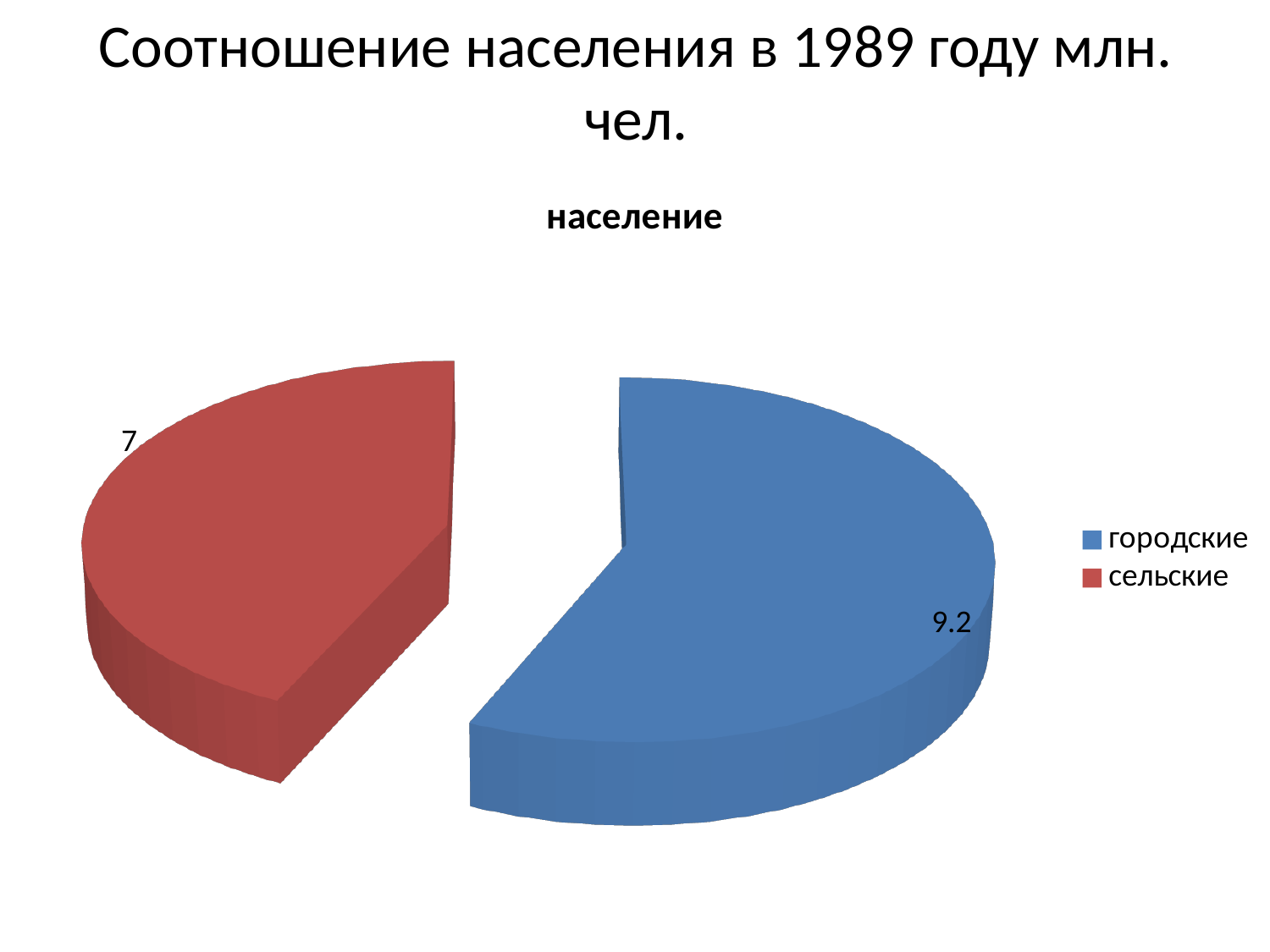
How many slices does the pie chart have? 2 What is the value for сельские? 7 Which category has the largest slice of the pie? городские Which is larger, the value for городские or the value for сельские? городские What is the total of the two slice values? 16.2 What share of the pie does городские represent, to the nearest whole percent? 57% What kind of chart is shown on the slide? pie chart What is the value for городские? 9.2 Which category has the smallest slice of the pie? сельские How many entries does the legend list? 2 What is the difference between the values for городские and сельские? 2.2 What colour is the slice for сельские? red